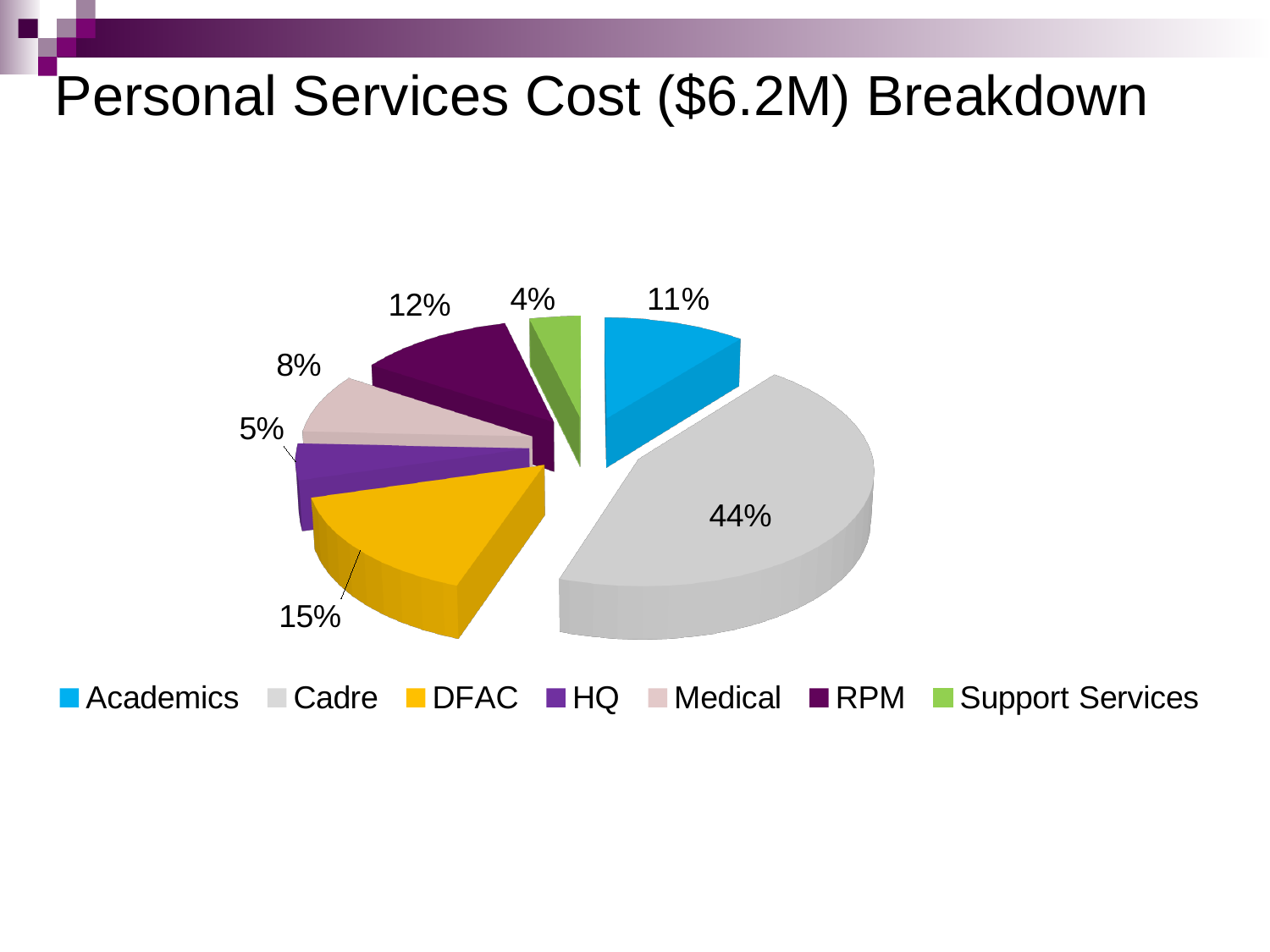
How many categories are shown in the pie chart? 7 What percentage is shown for Support Services? 4% Which is larger, the share for RPM or the share for Academics? RPM What percentage is shown for DFAC? 15% What is the title of the chart on the slide? Personal Services Cost ($6.2M) Breakdown What type of chart is shown on the slide? Pie chart What is the difference in percentage points between Cadre and DFAC? 29 What percentage is shown for Academics? 11% Which category has the largest share of the pie? Cadre What percentage is shown for Medical? 8% Which category has the smallest share of the pie? Support Services What share of the pie does Cadre represent? 44%